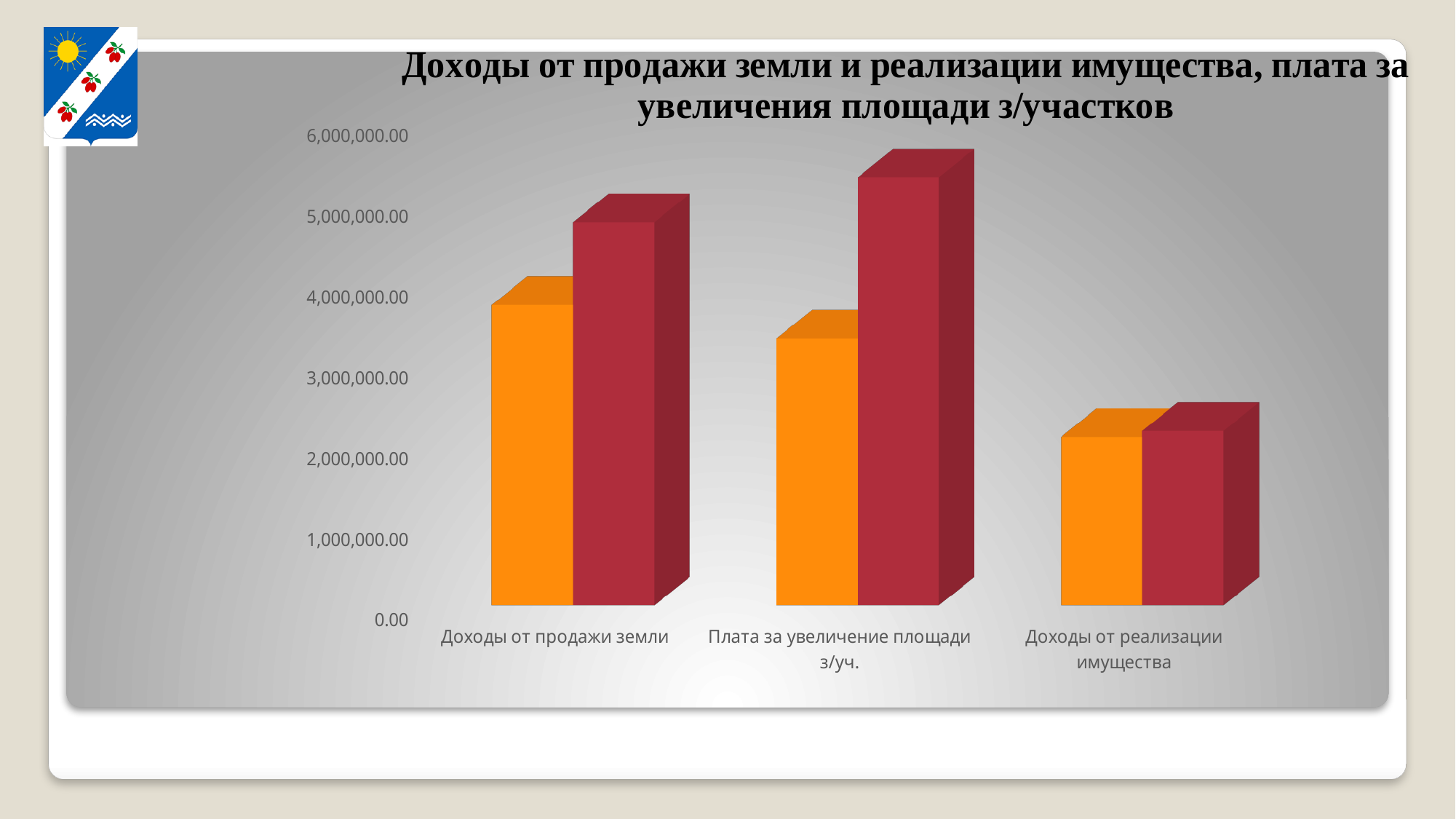
How many categories are shown on the x axis of the chart? 3 Which category has the shortest orange bar? Доходы от реализации имущества Is the orange bar for Доходы от продажи земли greater or less than 3,000,000.00? greater Is the orange bar for Доходы от реализации имущества greater or less than 3,000,000.00? less Is the red bar for Плата за увеличение площади з/уч. greater or less than 5,000,000.00? greater Which category has the tallest orange bar? Доходы от продажи земли What is the title of the chart? Доходы от продажи земли и реализации имущества, плата за увеличения площади з/участков Which category has the shortest red bar? Доходы от реализации имущества How many bars are shown for each category in the chart? 2 Which category has the tallest red bar? Плата за увеличение площади з/уч. For Доходы от продажи земли, which bar is taller, the orange one or the red one? the red one What kind of chart is shown on the slide? bar chart